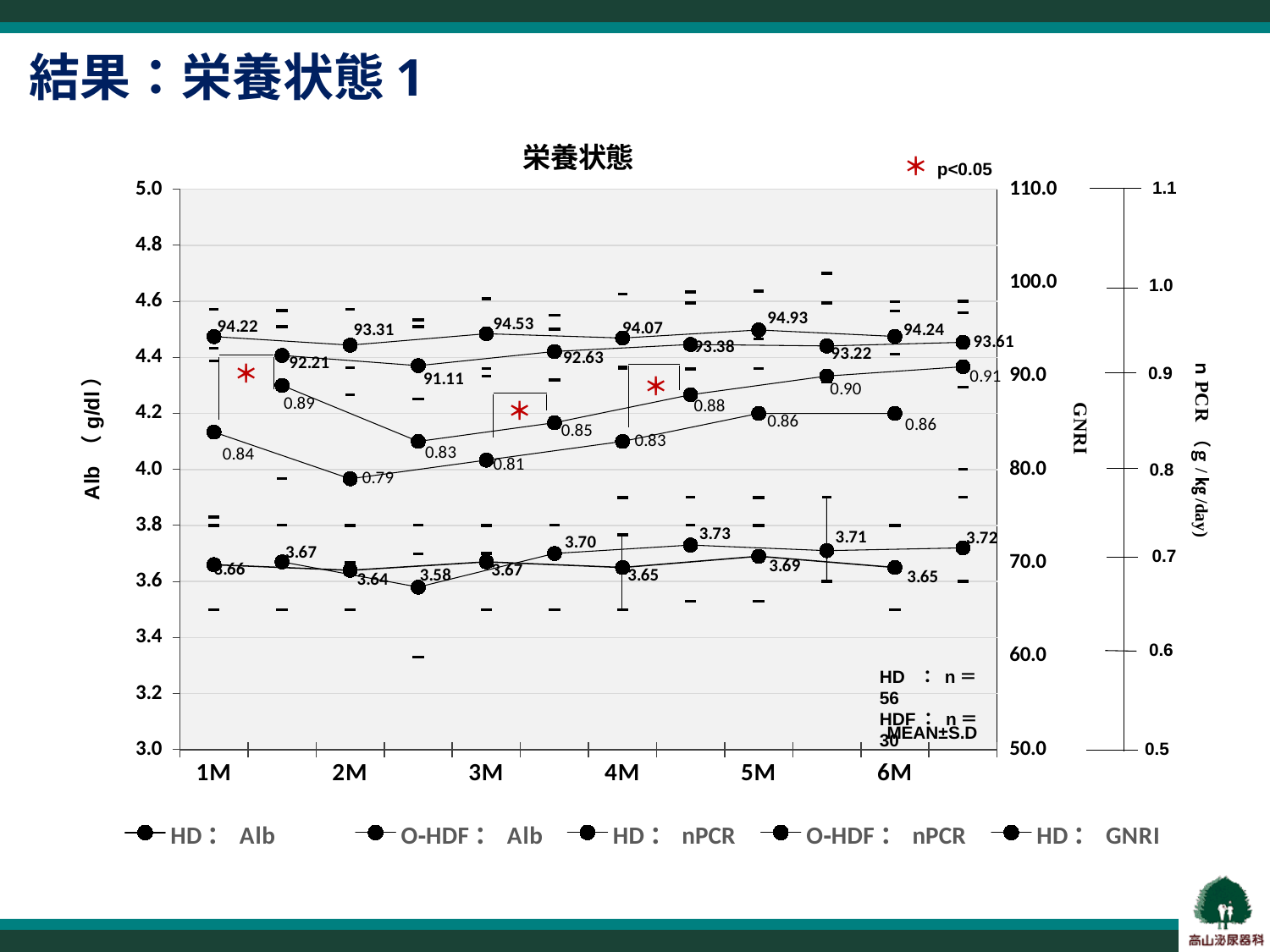
What is the highest labeled GNRI value on the chart? 94.93 Is the lowest labeled Alb value greater or less than 3.6? less What kind of chart is shown on the slide? line chart What is the highest labeled nPCR value on the chart? 0.91 What does the red asterisk (＊) on the chart indicate? p<0.05 What is the lowest labeled nPCR value on the chart? 0.79 What is the number of HD patients (n) noted on the chart? 56 How many series does the legend list? 5 What is the title of the chart? 栄養状態 What is the lowest labeled Alb value on the chart? 3.58 How many month labels are shown on the x axis? 6 What is the difference between the highest labeled nPCR value (0.91) and the lowest labeled nPCR value (0.79)? 0.12